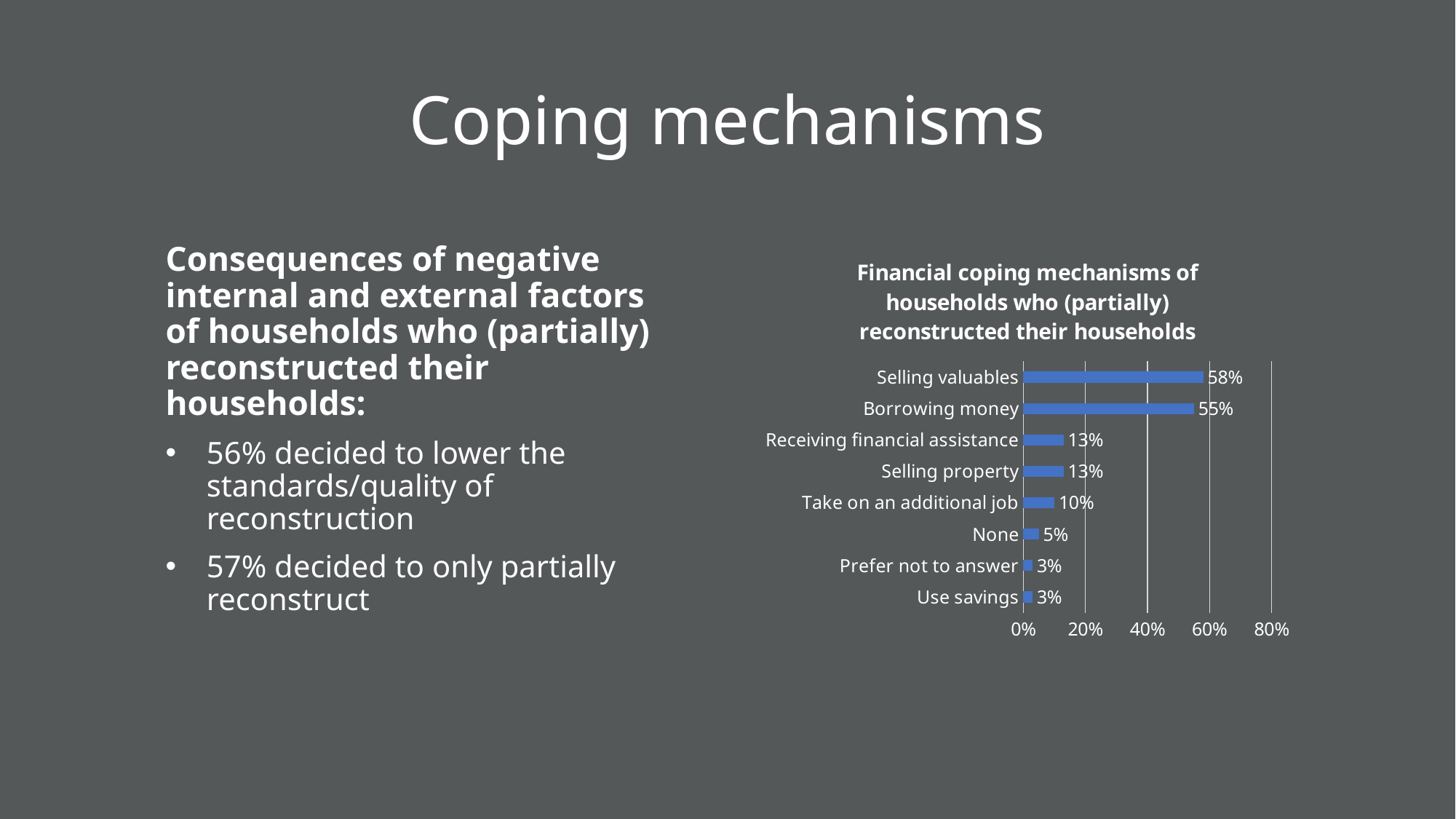
What is the value for Selling valuables? 58% What is the title of the chart? Financial coping mechanisms of households who (partially) reconstructed their households What is the value for Borrowing money? 55% What kind of chart is shown? Bar chart Which category has the highest value? Selling valuables What is the difference between Receiving financial assistance and Take on an additional job? 3% How many categories are shown in the chart? 8 Which is larger, Borrowing money or Selling property? Borrowing money What is the value for None? 5% What is the value for Take on an additional job? 10% What is the difference between Selling valuables and Borrowing money? 3% Is the value for Selling valuables greater or less than 40%? greater